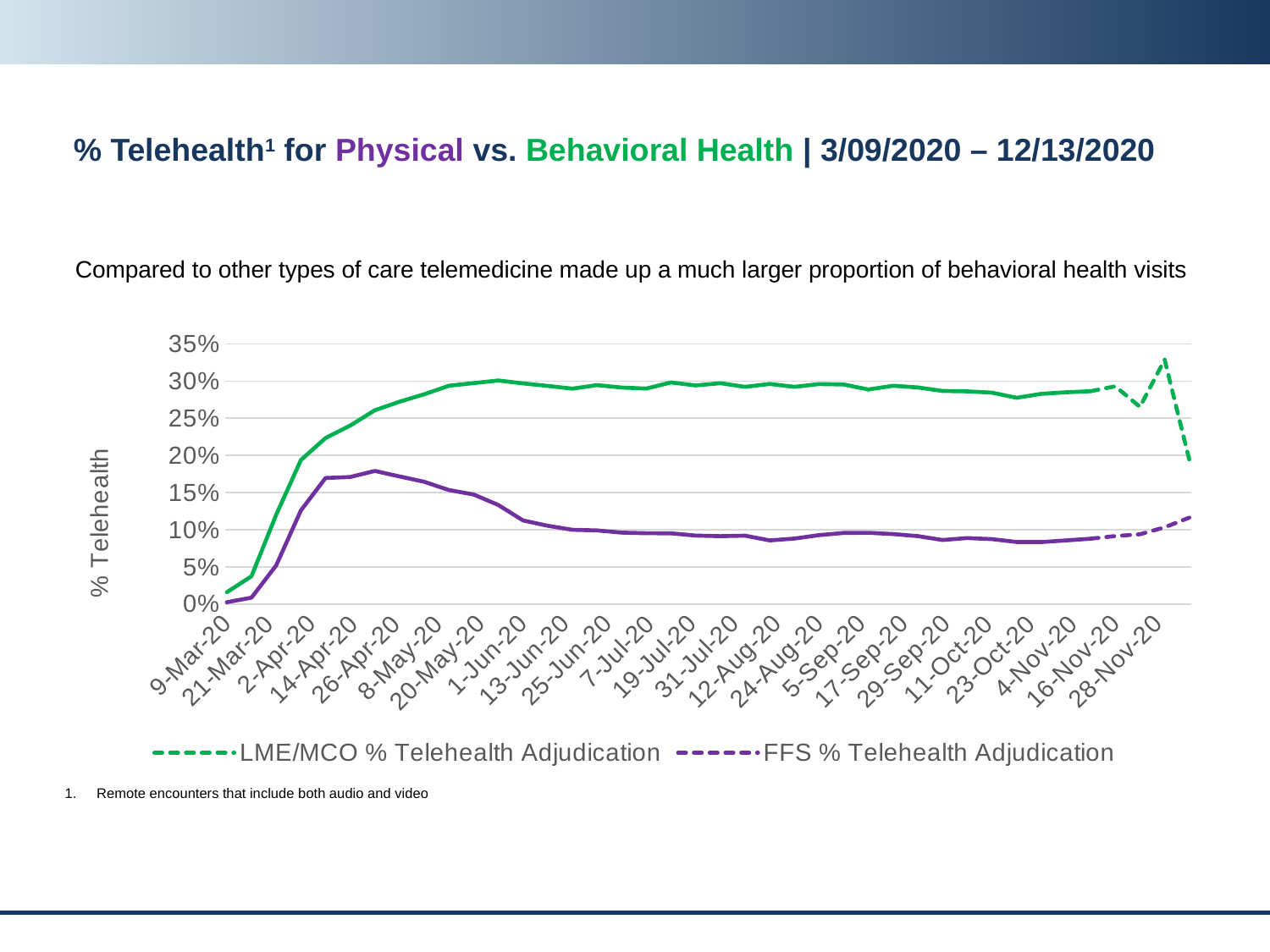
Which series has the higher value on 7-Jul-20, LME/MCO % Telehealth Adjudication or FFS % Telehealth Adjudication? LME/MCO % Telehealth Adjudication How many date labels are shown on the x axis? 23 Does the FFS % Telehealth Adjudication line rise or fall between 26-Apr-20 and 13-Jun-20? fall Which series is plotted in green? LME/MCO % Telehealth Adjudication Is the value for FFS % Telehealth Adjudication on 1-Jun-20 greater or less than 15%? less How many series does the legend list? 2 What is the label on the vertical axis? % Telehealth Is the value for LME/MCO % Telehealth Adjudication on 1-Jun-20 greater or less than 25%? greater What kind of chart is shown on the slide? line chart Is the value for FFS % Telehealth Adjudication on 9-Mar-20 greater or less than 5%? less Does the LME/MCO % Telehealth Adjudication line rise or fall between 9-Mar-20 and 8-May-20? rise